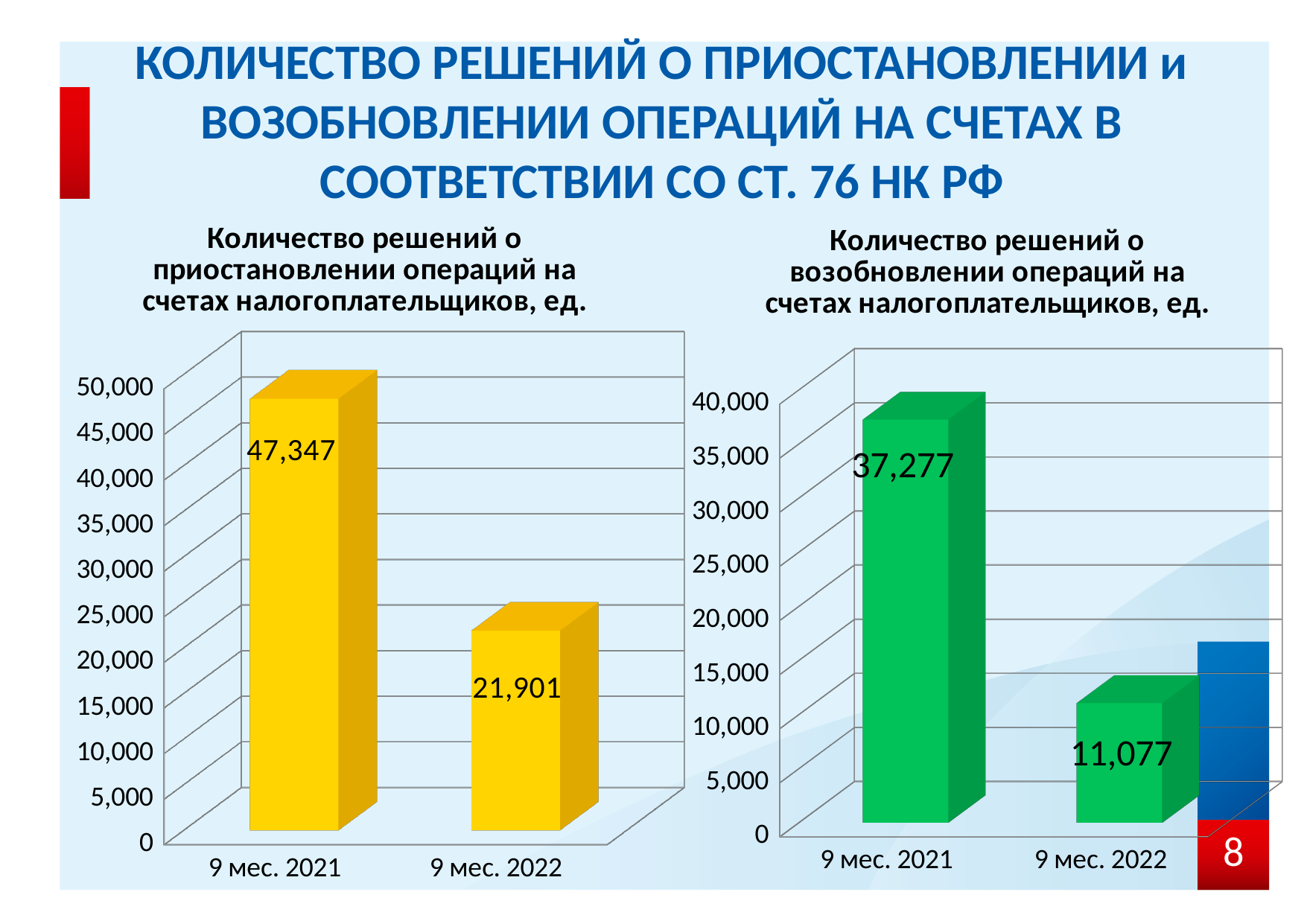
In the right chart (Количество решений о возобновлении операций на счетах налогоплательщиков, ед.), what is the value for 9 мес. 2021? 37,277 In the right chart, what is the difference between the values for 9 мес. 2021 and 9 мес. 2022? 26,200 In the left chart (Количество решений о приостановлении операций на счетах налогоплательщиков, ед.), what is the value for 9 мес. 2021? 47,347 In the left chart, which period has the higher value? 9 мес. 2021 In the left chart, what is the difference between the values for 9 мес. 2021 and 9 мес. 2022? 25,446 How many categories are shown on the x axis of the right chart? 2 In the right chart, which period has the lower value? 9 мес. 2022 Is the value for 9 мес. 2022 in the left chart greater or less than 25,000? less In the right chart (Количество решений о возобновлении операций на счетах налогоплательщиков, ед.), what is the value for 9 мес. 2022? 11,077 In the right chart, do the values rise or fall from 9 мес. 2021 to 9 мес. 2022? fall What kind of chart is the left chart? bar chart In the left chart (Количество решений о приостановлении операций на счетах налогоплательщиков, ед.), what is the value for 9 мес. 2022? 21,901